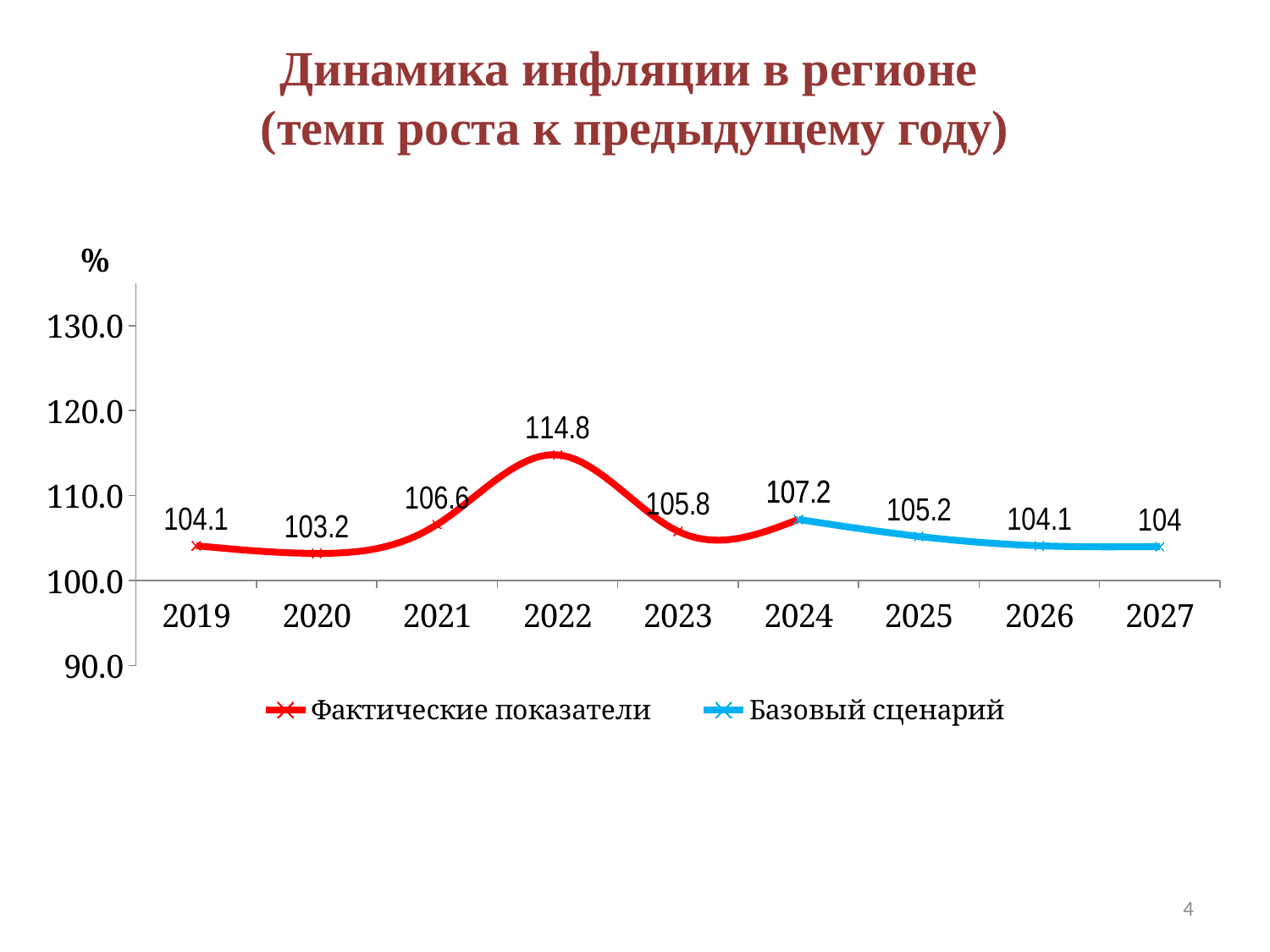
How many years are shown on the x axis? 9 What kind of chart is shown on the slide? line chart What is the value for 2022 on the chart? 114.8 Is the value for 2022 greater or less than 110.0? greater Which year has the highest value on the chart? 2022 How many series does the legend list? 2 Which year has the lowest value on the chart? 2020 What is the value for 2027 in the Базовый сценарий series? 104 What is the difference between the values for 2022 and 2021? 8.2 Which is larger, the value for 2024 or the value for 2023? 2024 Do the values rise or fall from 2024 to 2027? fall What is the value for 2019 on the chart? 104.1